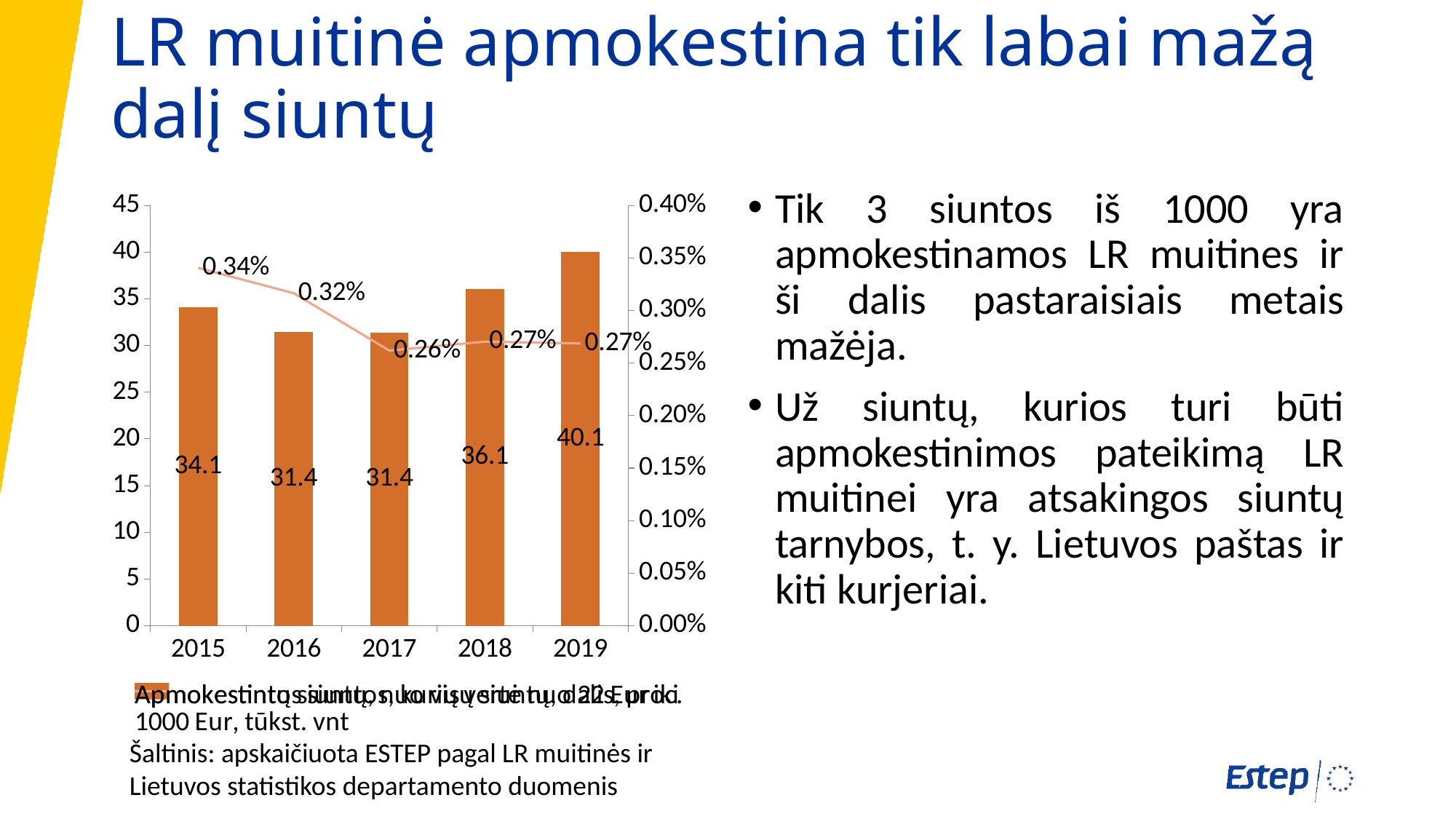
Which is larger, the bar value for 2018 or for 2016? 2018 What percentage does the line show for 2017? 0.26% What is the bar value for 2015? 34.1 How many years are shown on the x axis? 5 What is the difference between the bar values for 2019 and 2018? 4 What is the maximum value shown on the right-hand axis? 0.40% What kind of chart is shown on the slide? Combined bar and line chart Which year has the lowest value on the line series? 2017 Which year has the highest bar value? 2019 Does the line series rise or fall from 2015 to 2017? Fall What is the bar value for 2019? 40.1 What percentage does the line show for 2015? 0.34%